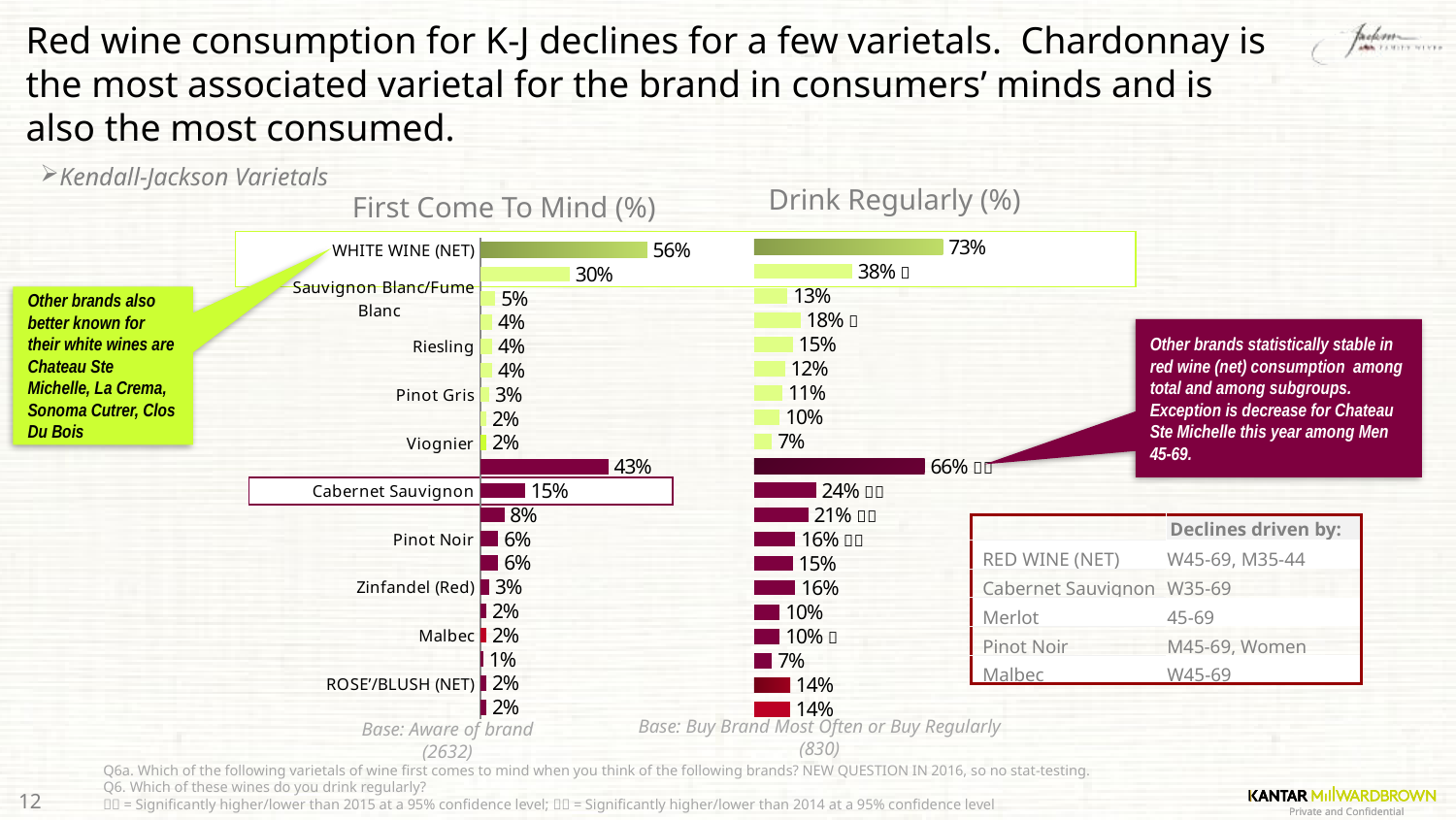
In the Drink Regularly (%) chart, what is the value for Riesling? 15% What type of chart is used for the First Come To Mind (%) data? Bar chart In the Drink Regularly (%) chart, what is the value for Cabernet Sauvignon? 24% In the Drink Regularly (%) chart, what is the value for Malbec? 10% In the Drink Regularly (%) chart, which labeled category has the highest value? WHITE WINE (NET) In the First Come To Mind (%) chart, what is the difference between WHITE WINE (NET) and Cabernet Sauvignon? 41 percentage points In the First Come To Mind (%) chart, what is the value for WHITE WINE (NET)? 56% In the Drink Regularly (%) chart, which is larger, Riesling or Pinot Gris? Riesling In the First Come To Mind (%) chart, what is the value for Cabernet Sauvignon? 15% In the First Come To Mind (%) chart, what is the value for Pinot Noir? 6% In the Drink Regularly (%) chart, what is the value for WHITE WINE (NET)? 73% In the Drink Regularly (%) chart, what is the difference between WHITE WINE (NET) and Cabernet Sauvignon? 49 percentage points